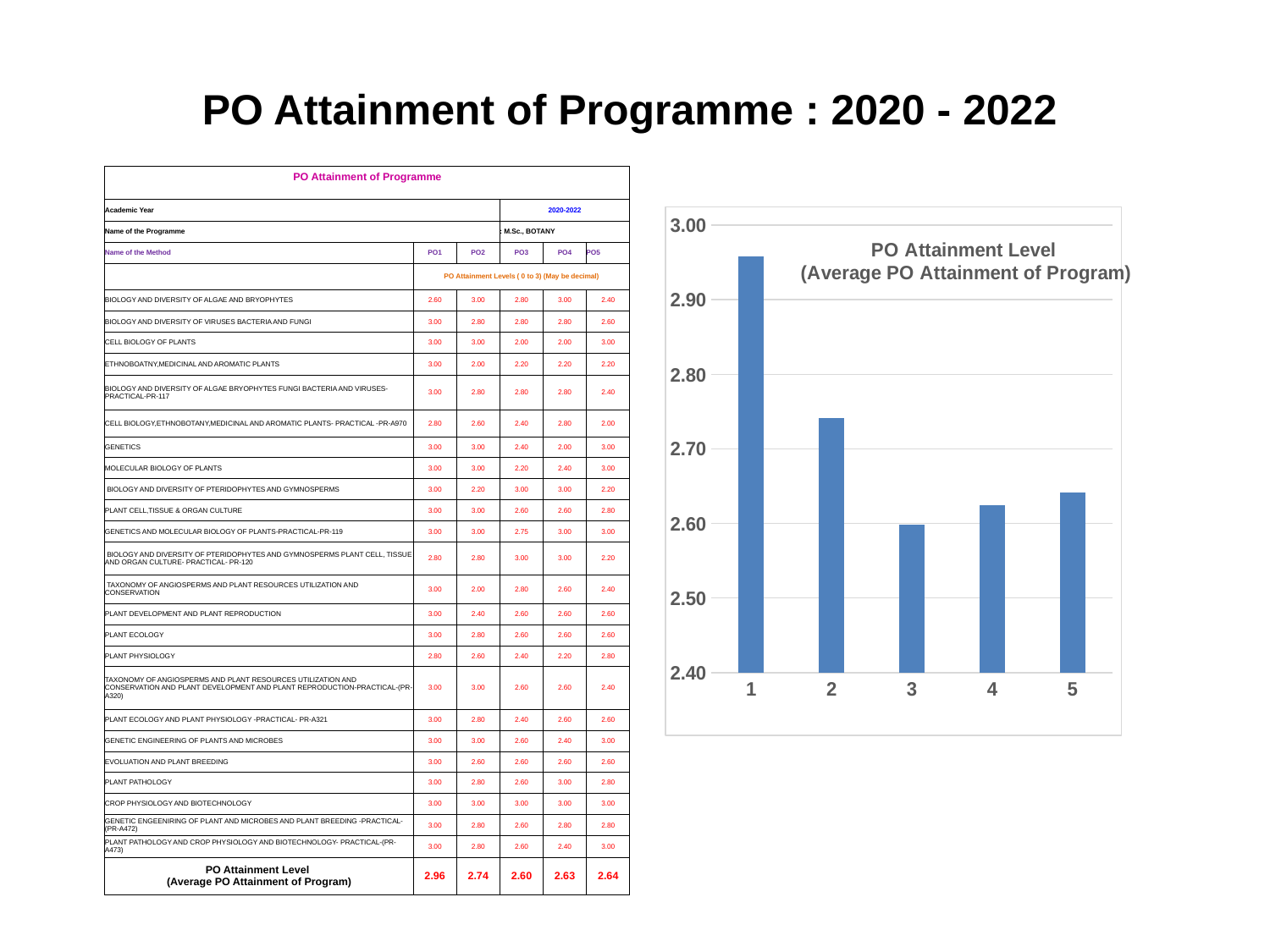
Is the value for category 1 greater or less than 2.90? greater Is the value for category 5 greater or less than 2.70? less How many bars are plotted in the chart? 5 Which is larger, the value for category 1 or category 2? category 1 What kind of chart is shown on the slide? bar chart Is the value for category 4 greater or less than 2.60? greater What is the title of the chart? PO Attainment Level (Average PO Attainment of Program) Which category has the highest bar in the chart? 1 Which is larger, the value for category 2 or category 5? category 2 Which category has the lowest bar in the chart? 3 What is the lowest value shown on the vertical axis of the chart? 2.40